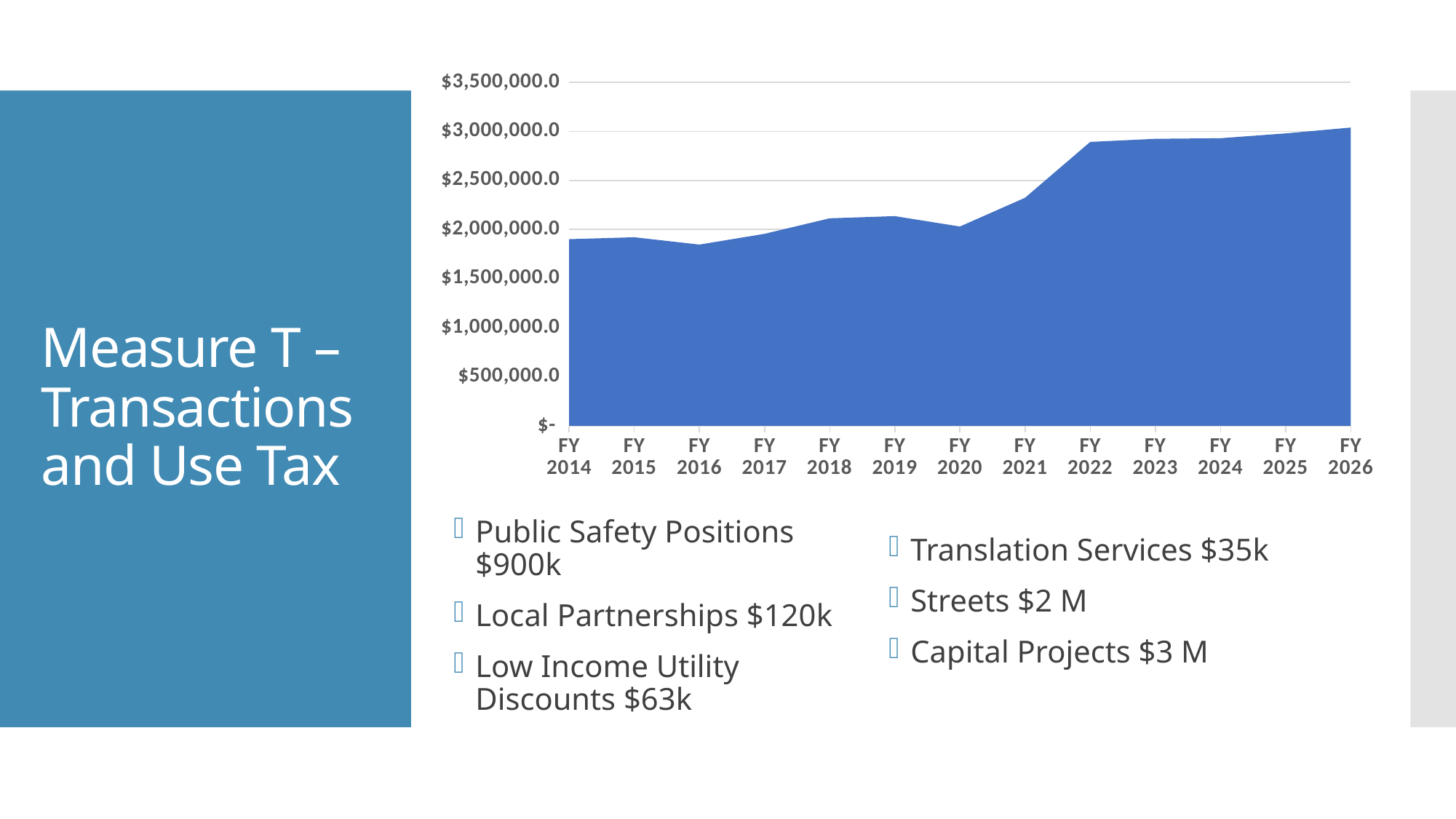
What is the first fiscal year shown on the x axis of the chart? FY 2014 Is the value for FY 2021 greater or less than $2,500,000.0? less Is the value for FY 2014 greater or less than $2,000,000.0? less Is the value for FY 2018 greater or less than $2,000,000.0? greater What kind of chart is shown on the slide? area chart Which is larger, the value for FY 2016 or the value for FY 2022? FY 2022 Which fiscal year has the highest value in the chart? FY 2026 Do the values generally rise or fall from FY 2014 to FY 2026? rise Which is larger, the value for FY 2020 or the value for FY 2021? FY 2021 How many fiscal years are plotted along the x axis of the chart? 13